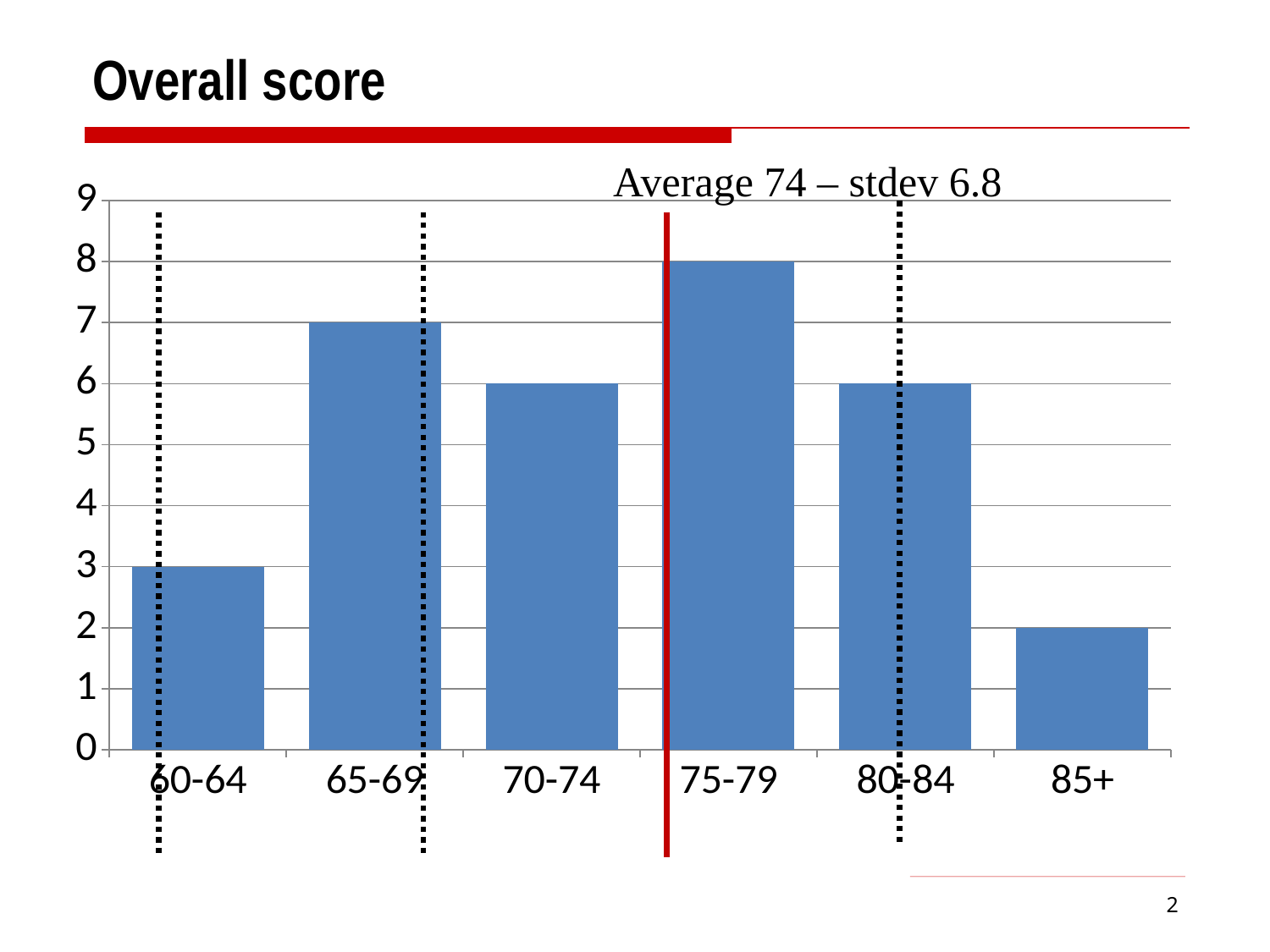
What is the value for the 75-79 score range? 8 What is the difference between the values for 75-79 and 60-64? 5 How many score ranges (categories) are shown on the x axis? 6 Is the value for 80-84 greater or less than 5? greater What is the value for the 65-69 score range? 7 What average and standard deviation are stated in the text above the chart? Average 74 – stdev 6.8 Which is larger, the value for 65-69 or the value for 70-74? 65-69 Which score range has the highest bar? 75-79 What kind of chart is shown on the slide? bar chart Which score range has the lowest bar? 85+ What is the value for the 85+ score range? 2 What is the value for the 60-64 score range? 3